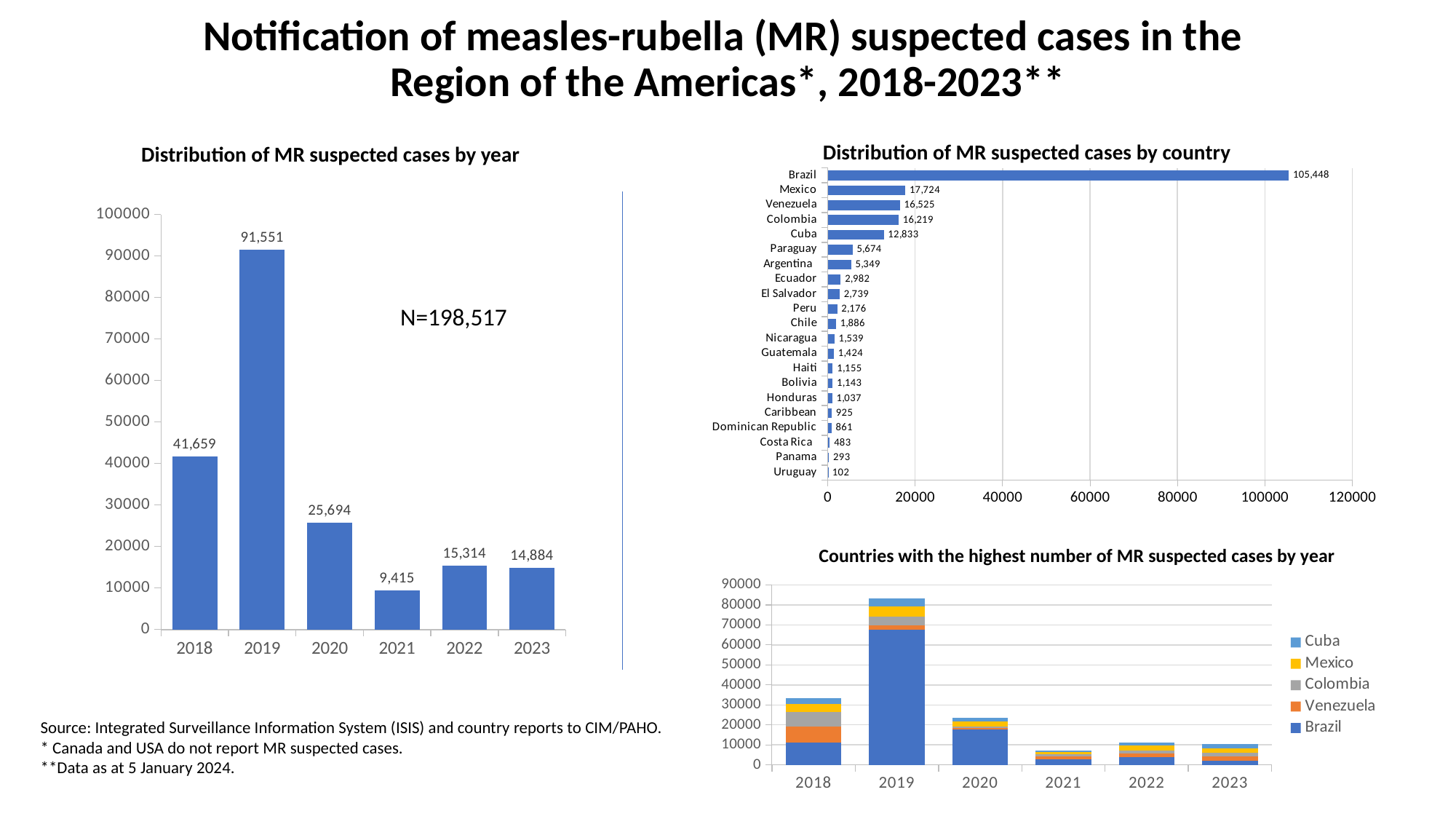
In the 'Distribution of MR suspected cases by country' chart, how many countries are listed? 21 In the 'Distribution of MR suspected cases by year' chart, how many years are shown? 6 In the 'Distribution of MR suspected cases by country' chart, which country has the lowest number of cases? Uruguay In the 'Distribution of MR suspected cases by country' chart, what is the value for Cuba? 12,833 In the 'Distribution of MR suspected cases by year' chart, which year has the lowest number of cases? 2021 In the 'Distribution of MR suspected cases by country' chart, which country has the highest number of cases? Brazil In the 'Countries with the highest number of MR suspected cases by year' chart, how many series does the legend list? 5 In the 'Distribution of MR suspected cases by year' chart, what is the value for 2019? 91,551 In the 'Distribution of MR suspected cases by country' chart, which has more cases, Venezuela or Colombia? Venezuela In the 'Countries with the highest number of MR suspected cases by year' chart, is the total stacked value for 2019 greater or less than 80000? greater In the 'Distribution of MR suspected cases by year' chart, what is the difference between the 2018 and 2020 values? 15,965 In the 'Distribution of MR suspected cases by year' chart, what total N is printed on the chart? N=198,517